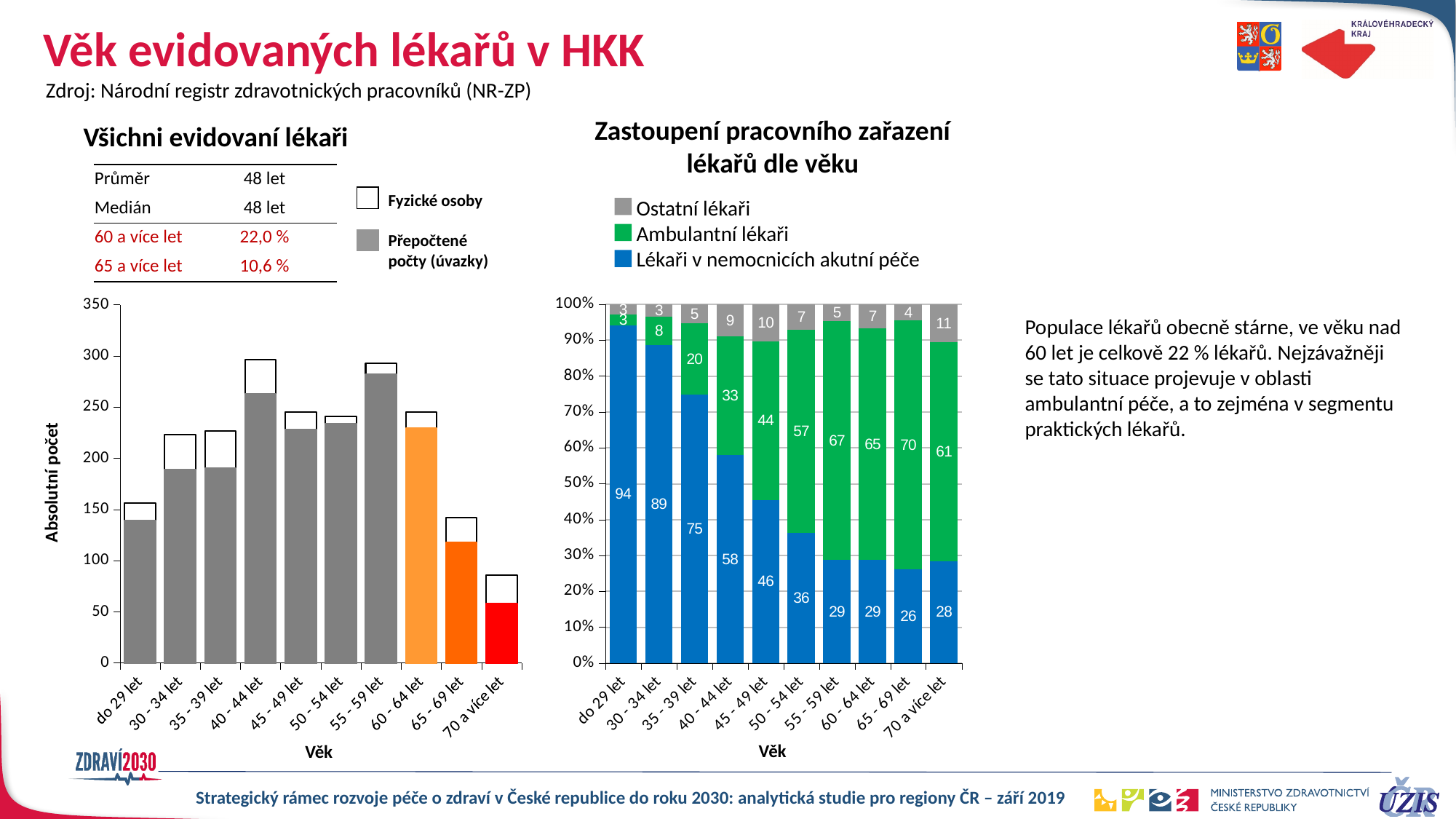
How many age groups are shown on the x axis of the chart 'Všichni evidovaní lékaři'? 10 In the chart 'Zastoupení pracovního zařazení lékařů dle věku', what is the value for 'Lékaři v nemocnicích akutní péče' in the 'do 29 let' age group? 94 In the chart 'Zastoupení pracovního zařazení lékařů dle věku', which age group has the lowest value for 'Lékaři v nemocnicích akutní péče'? 65 - 69 let In the chart 'Zastoupení pracovního zařazení lékařů dle věku', what is the value for 'Ostatní lékaři' in the '70 a více let' age group? 11 In the chart 'Všichni evidovaní lékaři', which age group has the lowest value for 'Přepočtené počty (úvazky)'? 70 a více let In the chart 'Všichni evidovaní lékaři', is the 'Přepočtené počty (úvazky)' value for '70 a více let' greater or less than 100? less In the chart 'Zastoupení pracovního zařazení lékařů dle věku', what is the difference between the 'Lékaři v nemocnicích akutní péče' values for 'do 29 let' and '70 a více let'? 66 What kind of chart is 'Všichni evidovaní lékaři'? bar chart In the chart 'Zastoupení pracovního zařazení lékařů dle věku', what is the value for 'Ambulantní lékaři' in the '55 - 59 let' age group? 67 How many series does the legend of the chart 'Zastoupení pracovního zařazení lékařů dle věku' list? 3 In the chart 'Zastoupení pracovního zařazení lékařů dle věku', for the '40 - 44 let' group, which is larger: 'Lékaři v nemocnicích akutní péče' or 'Ambulantní lékaři'? Lékaři v nemocnicích akutní péče In the chart 'Zastoupení pracovního zařazení lékařů dle věku', which age group has the highest value for 'Lékaři v nemocnicích akutní péče'? do 29 let